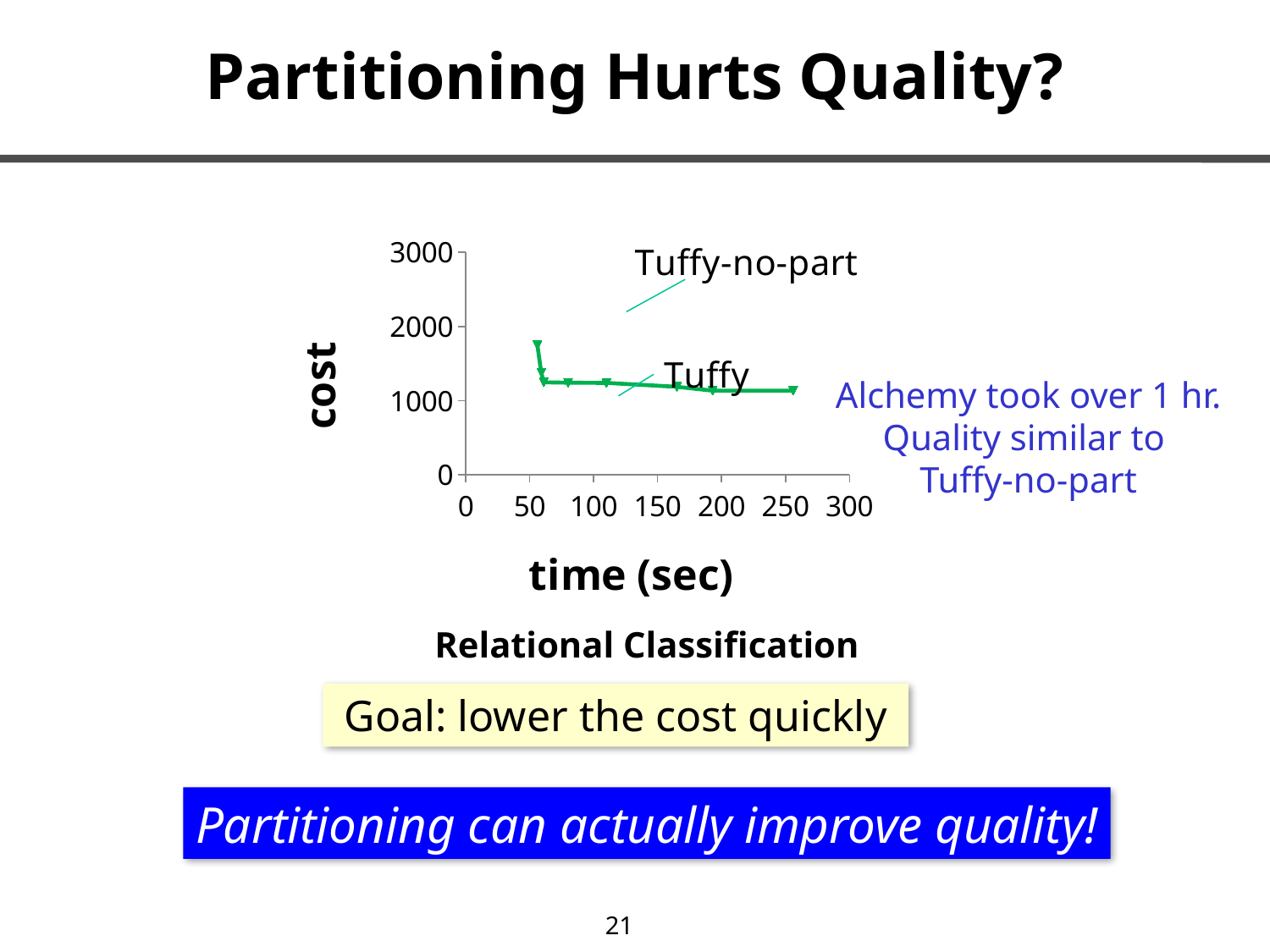
What are the names of the two series plotted on the chart? Tuffy-no-part and Tuffy What kind of chart is shown on the slide? line chart Does the cost rise or fall as time increases along the x axis? fall What is the label of the y axis? cost What is the title printed beneath the chart? Relational Classification Is the cost at the end of the Tuffy line (around 250 sec) greater or less than 2000? less Is the highest cost value plotted on the chart greater or less than 1000? greater How many series are labelled on the chart? 2 Is the highest cost value plotted on the chart greater or less than 2000? less